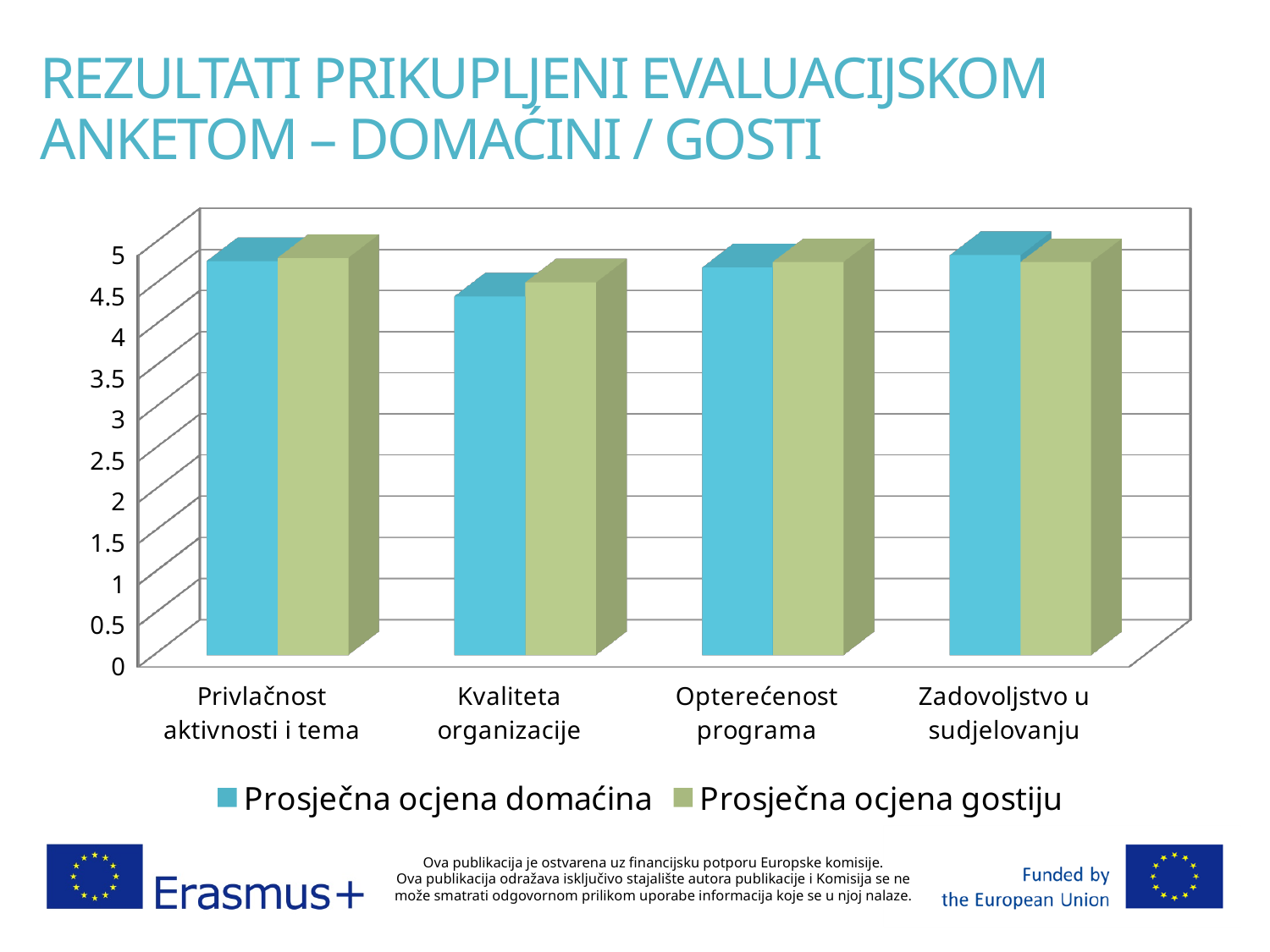
Is the value for Zadovoljstvo u sudjelovanju in the Prosječna ocjena domaćina series greater or less than 4.5? greater What kind of chart is shown on the slide? bar chart What is the name of the second series listed in the chart's legend? Prosječna ocjena gostiju Which colour represents the Prosječna ocjena domaćina series in the chart? blue Which category has the lowest value for Prosječna ocjena gostiju? Kvaliteta organizacije For Kvaliteta organizacije, which series has the larger value: Prosječna ocjena domaćina or Prosječna ocjena gostiju? Prosječna ocjena gostiju Which category has the highest value for Prosječna ocjena domaćina? Zadovoljstvo u sudjelovanju How many categories are shown on the x axis of the chart? 4 Is the value for Privlačnost aktivnosti i tema in the Prosječna ocjena gostiju series greater or less than 4? greater Which category has the lowest value for Prosječna ocjena domaćina? Kvaliteta organizacije Is the value for Kvaliteta organizacije in the Prosječna ocjena domaćina series greater or less than 4? greater How many series does the chart's legend list? 2